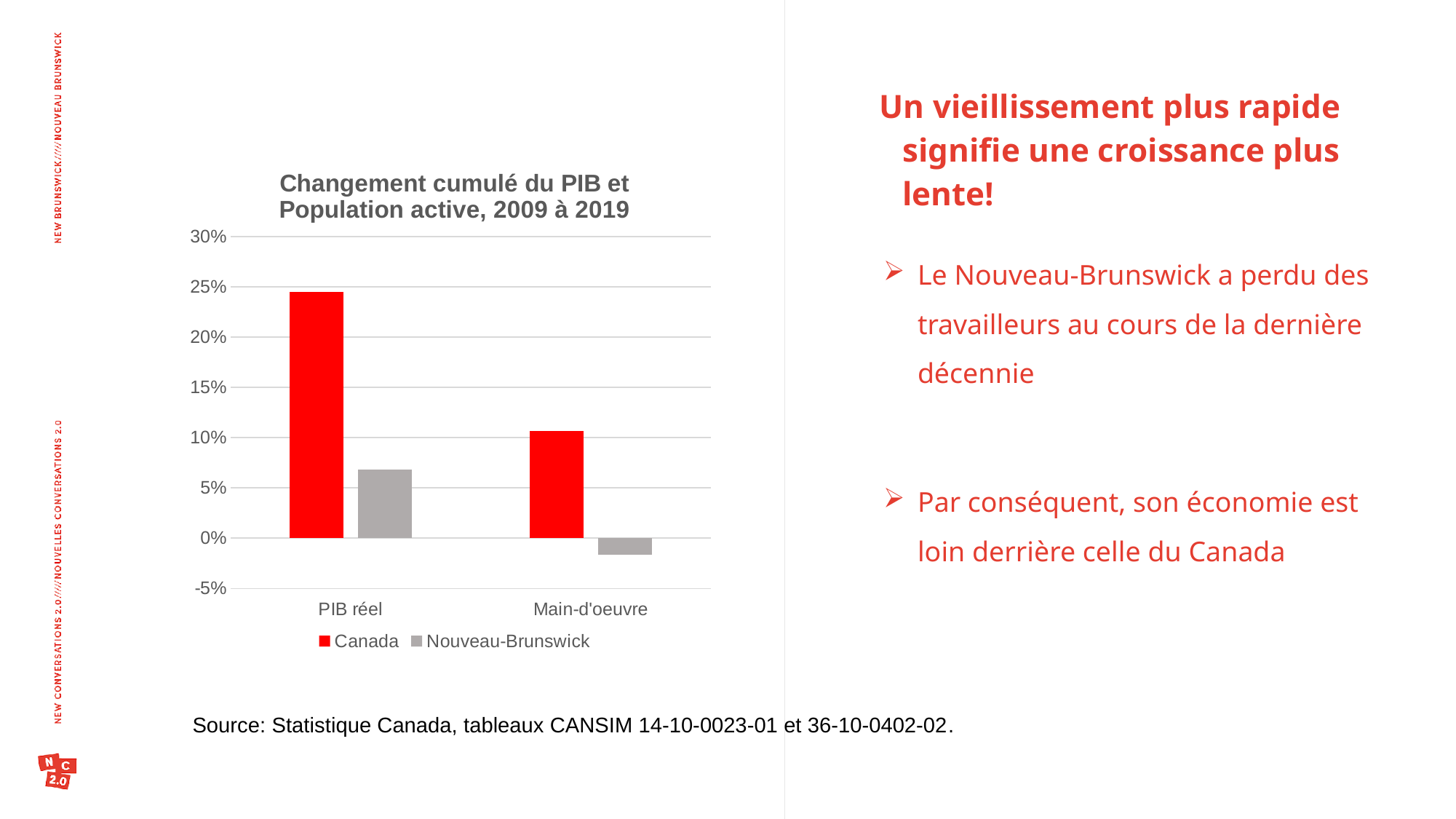
Which series is shown in red? Canada Which is larger for PIB réel: Canada or Nouveau-Brunswick? Canada Which bar is the highest in the chart? Canada, PIB réel Is the value for Canada in PIB réel greater or less than 20%? greater How many categories are shown on the x axis? 2 Is the value for Nouveau-Brunswick in PIB réel greater or less than 10%? less What is the title of the chart? Changement cumulé du PIB et Population active, 2009 à 2019 How many series does the legend list? 2 Which bar is the lowest in the chart? Nouveau-Brunswick, Main-d'oeuvre What kind of chart is shown on the slide? bar chart Is the value for Nouveau-Brunswick in Main-d'oeuvre greater or less than 0%? less